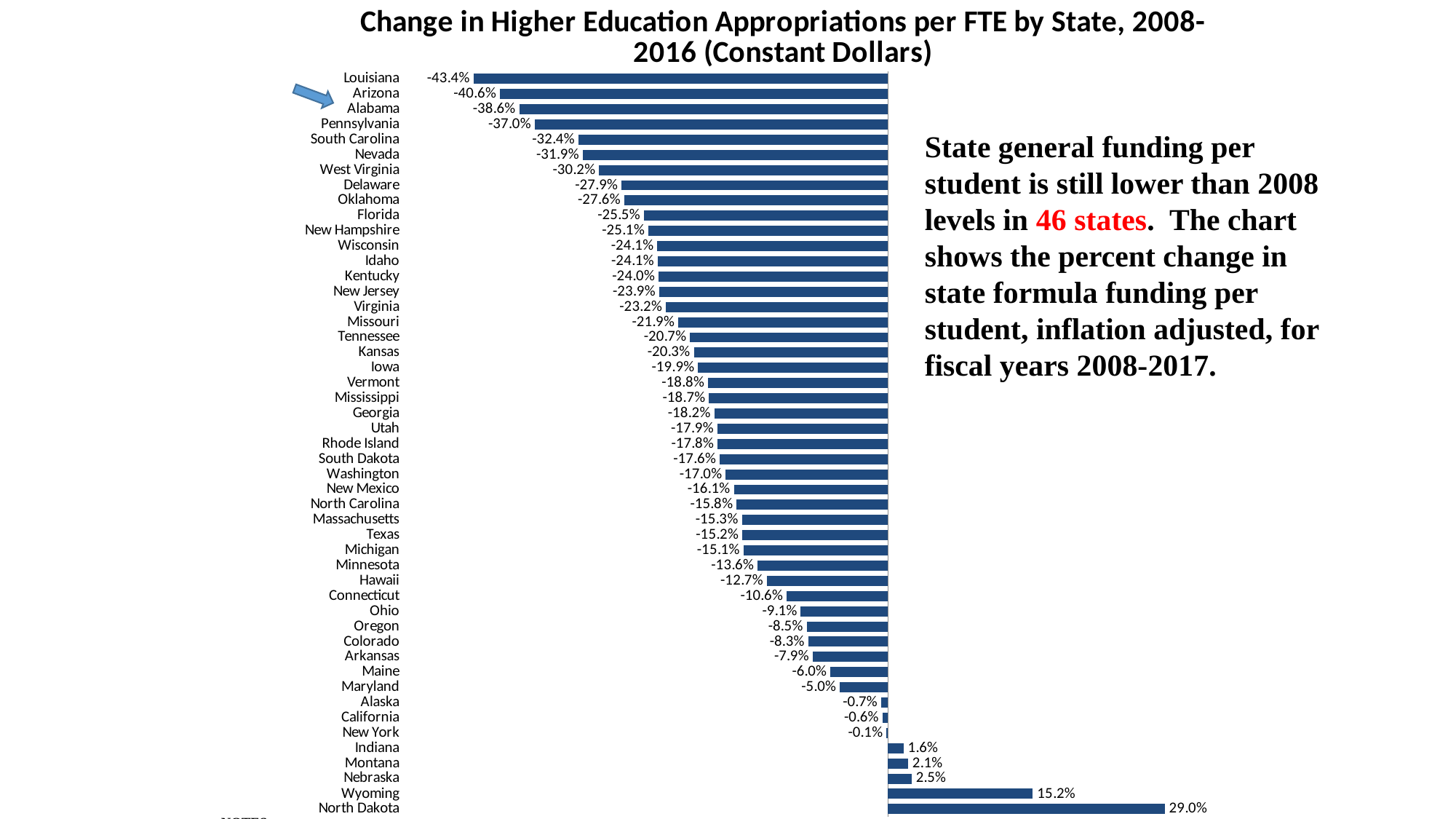
Which state has the lowest change in appropriations per FTE? Louisiana What is the difference between the values for North Dakota and Wyoming? 13.8 percentage points What is the title of the chart? Change in Higher Education Appropriations per FTE by State, 2008-2016 (Constant Dollars) What kind of chart is shown on the slide? bar chart What is the value shown for Wyoming? 15.2% Which state has the highest change in appropriations per FTE? North Dakota How many states show a positive change in appropriations per FTE? 5 What is the value shown for Texas? -15.2% Which state has a larger (less negative) value, Florida or Nevada? Florida What is the change in higher education appropriations per FTE for Louisiana? -43.4% What is the value shown for Alabama? -38.6% What is the difference between the values for Louisiana and Arizona? 2.8 percentage points